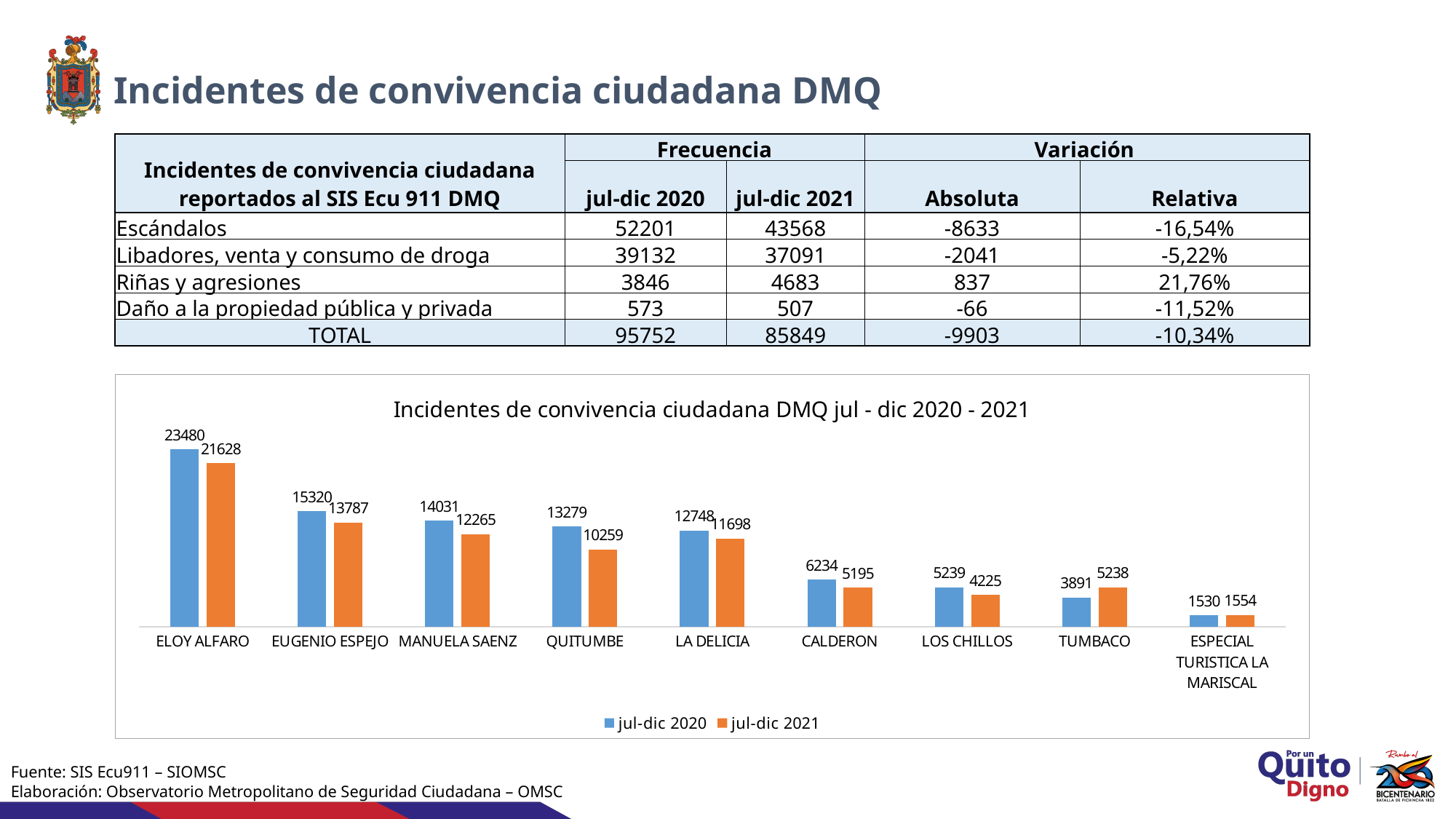
What is the jul-dic 2020 value for ELOY ALFARO? 23480 Which category has the highest jul-dic 2020 value? ELOY ALFARO Which is larger: the jul-dic 2021 value for CALDERON or the jul-dic 2021 value for LOS CHILLOS? CALDERON What is the jul-dic 2021 value for TUMBACO? 5238 For TUMBACO, which is larger: the jul-dic 2020 value or the jul-dic 2021 value? jul-dic 2021 What is the jul-dic 2021 value for QUITUMBE? 10259 What kind of chart is shown on the slide? Bar chart What is the difference between the jul-dic 2020 and jul-dic 2021 values for ELOY ALFARO? 1852 How many series does the chart legend list? 2 What is the difference between the jul-dic 2020 values for EUGENIO ESPEJO and MANUELA SAENZ? 1289 How many categories are shown on the x axis of the chart? 9 Which category has the lowest jul-dic 2021 value? ESPECIAL TURISTICA LA MARISCAL